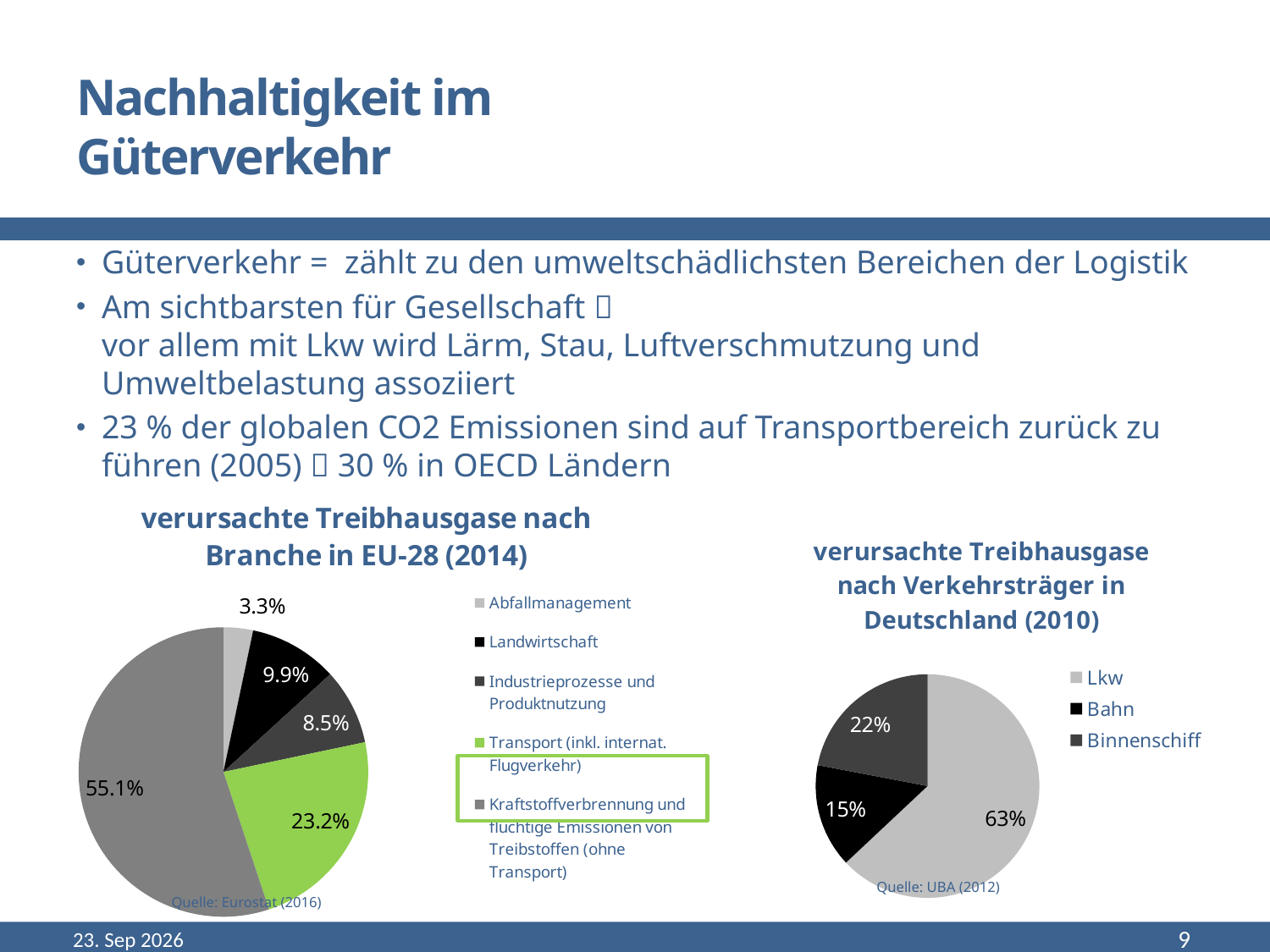
In the chart 'verursachte Treibhausgase nach Verkehrsträger in Deutschland (2010)', what is the difference between the Lkw and Bahn shares? 48% What type of chart is 'verursachte Treibhausgase nach Verkehrsträger in Deutschland (2010)'? Pie chart In the chart 'verursachte Treibhausgase nach Verkehrsträger in Deutschland (2010)', which is larger, Bahn or Binnenschiff? Binnenschiff In the chart 'verursachte Treibhausgase nach Verkehrsträger in Deutschland (2010)', what share does Lkw have? 63% In the chart 'verursachte Treibhausgase nach Branche in EU-28 (2014)', what share does Landwirtschaft have? 9.9% In the chart 'verursachte Treibhausgase nach Verkehrsträger in Deutschland (2010)', what share does Binnenschiff have? 22% In the chart 'verursachte Treibhausgase nach Branche in EU-28 (2014)', which category has the smallest slice? Abfallmanagement In the chart 'verursachte Treibhausgase nach Branche in EU-28 (2014)', how many categories are shown? 5 In the chart 'verursachte Treibhausgase nach Branche in EU-28 (2014)', which category has the largest slice? Kraftstoffverbrennung und flüchtige Emissionen von Treibstoffen (ohne Transport) In the chart 'verursachte Treibhausgase nach Branche in EU-28 (2014)', what is the difference between the Transport slice and the Industrieprozesse und Produktnutzung slice? 14.7% In the chart 'verursachte Treibhausgase nach Verkehrsträger in Deutschland (2010)', which category has the smallest slice? Bahn In the chart 'verursachte Treibhausgase nach Branche in EU-28 (2014)', what share does Transport (inkl. internat. Flugverkehr) have? 23.2%